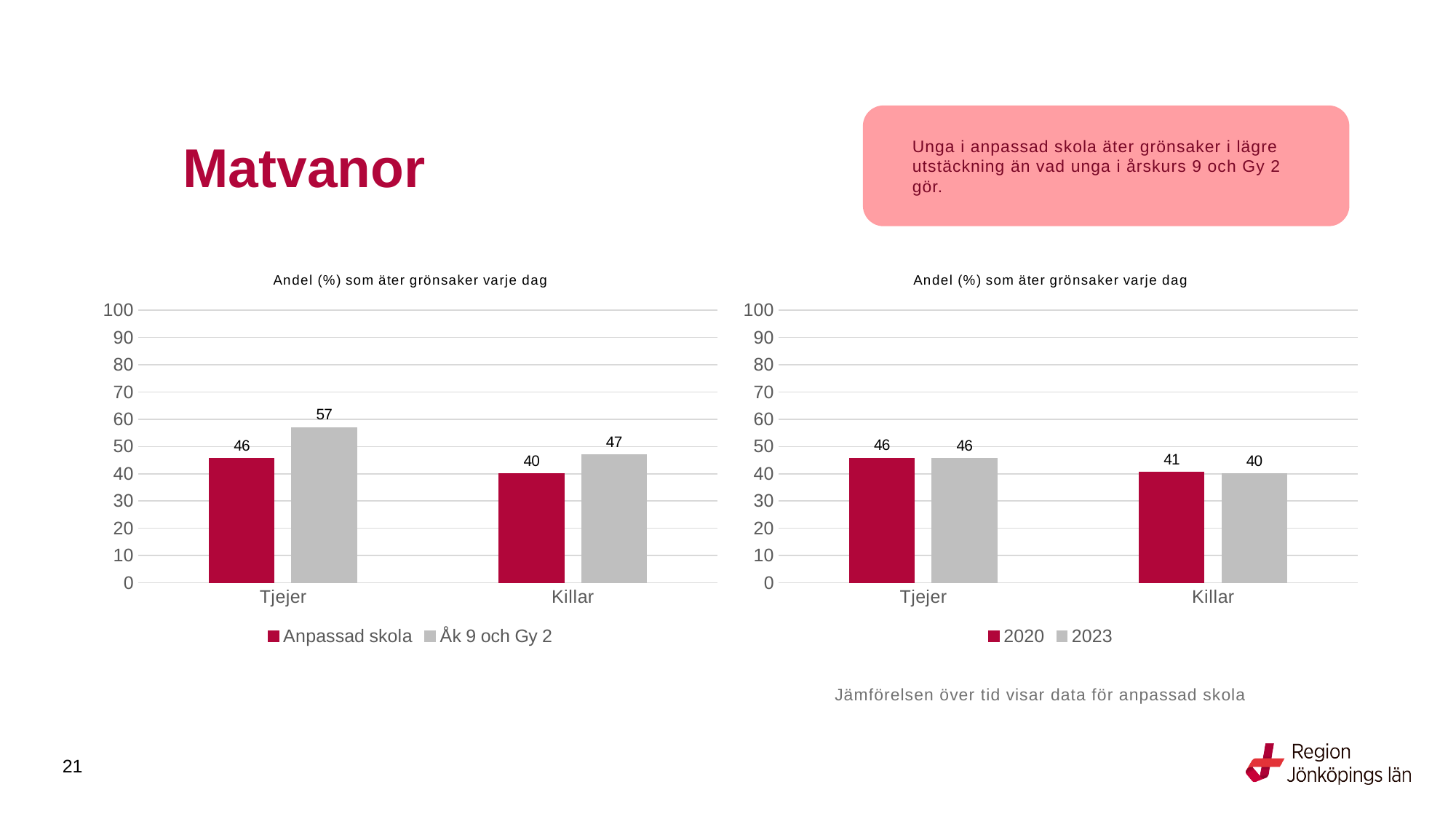
In the left chart, what is the difference between Åk 9 och Gy 2 and Anpassad skola among Tjejer? 11 How many series does the legend of the right chart list? 2 What type of chart is the left chart? Bar chart In the left chart, what is the difference between Åk 9 och Gy 2 and Anpassad skola among Killar? 7 In the left chart, which bar has the highest value? Åk 9 och Gy 2 among Tjejer In the left chart, what is the value for Anpassad skola among Killar? 40 In the left chart, what is the value for Åk 9 och Gy 2 among Tjejer? 57 In the right chart, what is the value for 2023 among Tjejer? 46 What are the two series listed in the legend of the left chart? Anpassad skola and Åk 9 och Gy 2 In the right chart, what is the value for 2020 among Killar? 41 In the right chart, which bar has the lowest value? 2023 among Killar In the left chart, which series has the higher value among Killar, Anpassad skola or Åk 9 och Gy 2? Åk 9 och Gy 2